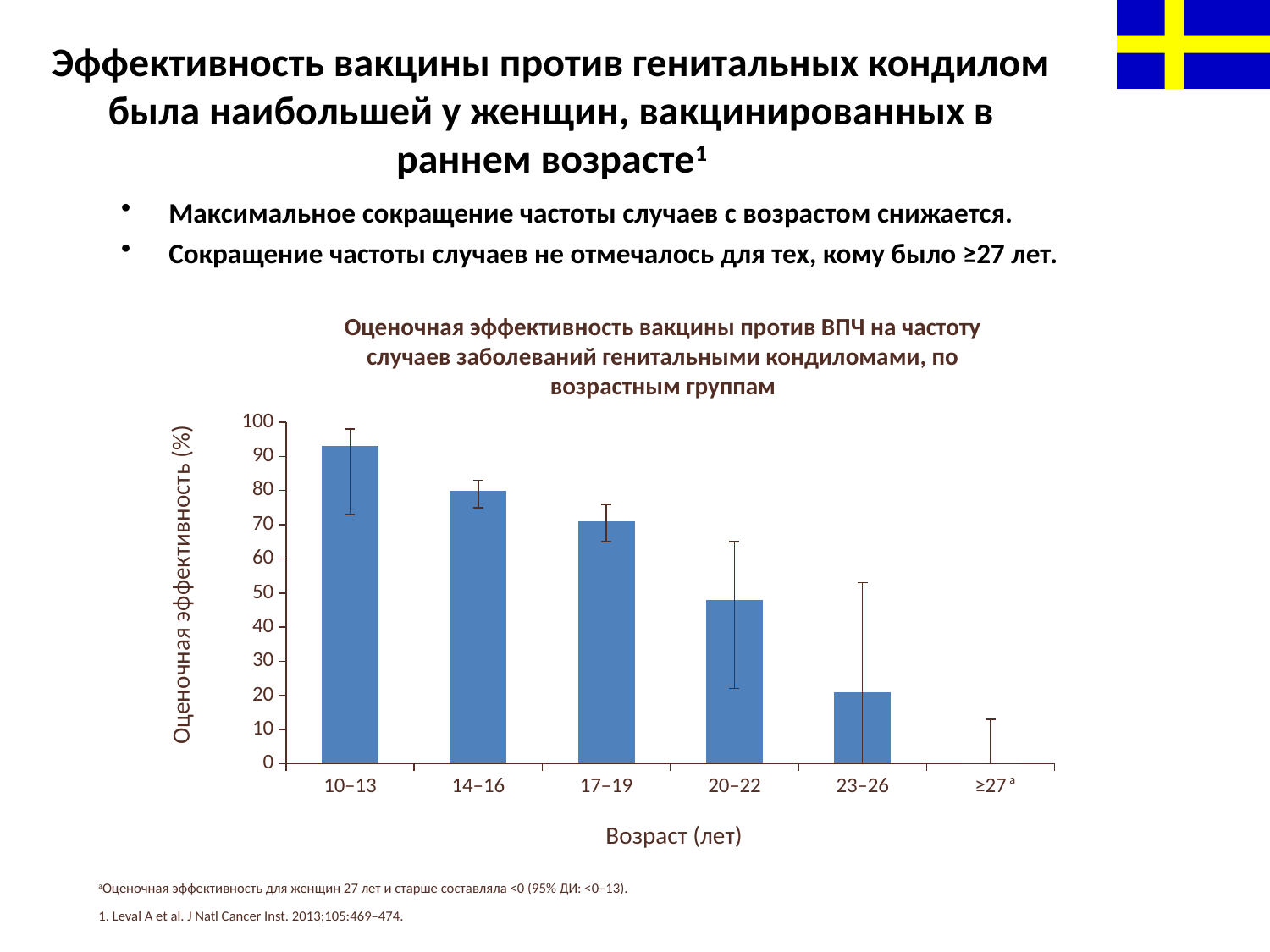
What kind of chart is shown on the slide? bar chart Is the value for the 10–13 age group greater or less than 80? greater Is the value for the 20–22 age group greater or less than 50? less Do the bar values rise or fall as age increases along the x axis? fall How many age groups are shown on the x axis of the chart? 6 Is the value for the 23–26 age group greater or less than 30? less Which age group has the highest estimated vaccine effectiveness? 10–13 Which age group has a larger value, 14–16 or 20–22? 14–16 What is the title of the x axis of the chart? Возраст (лет) Which age group has the lowest estimated vaccine effectiveness? ≥27